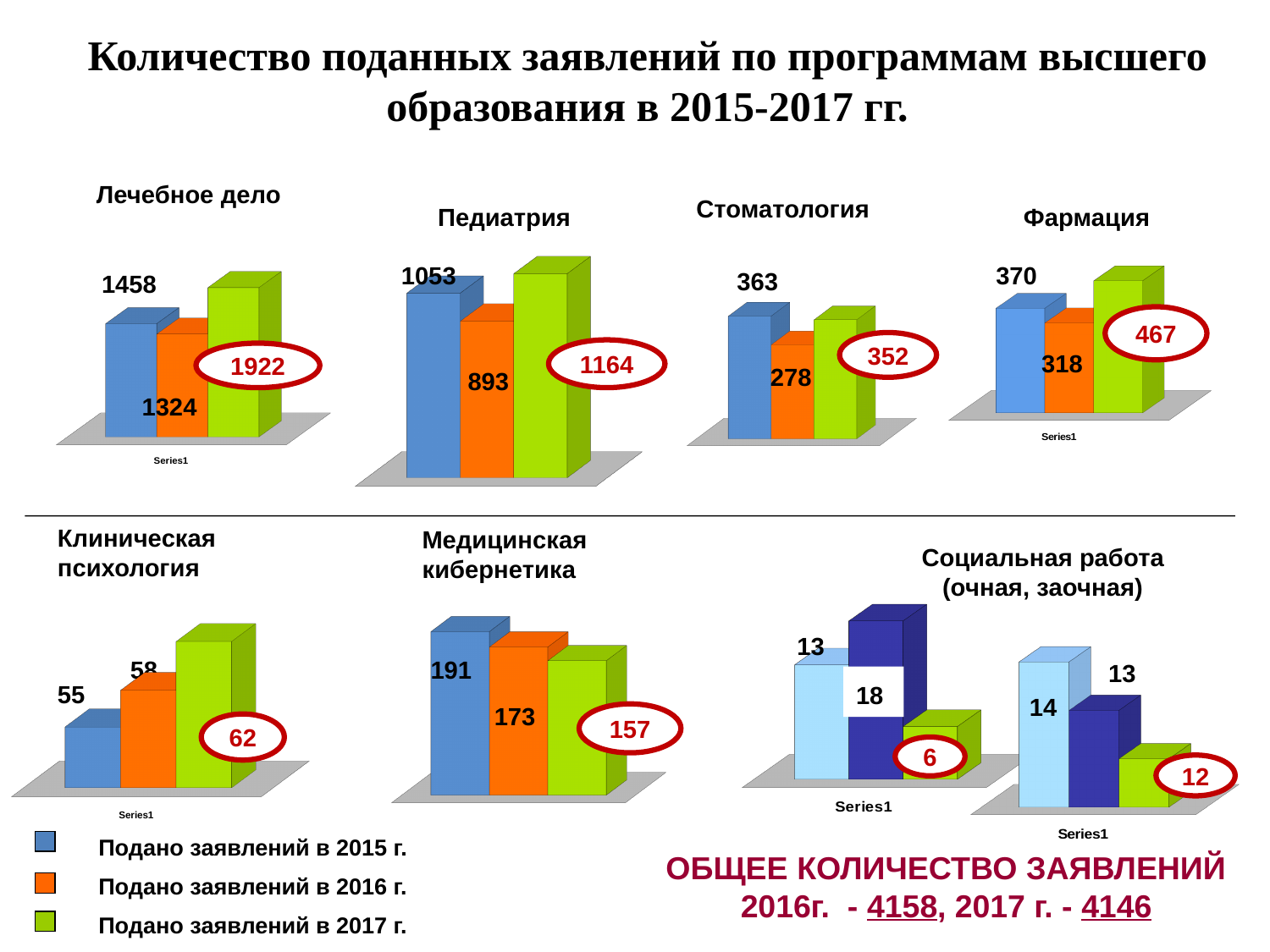
In the Стоматология chart, which year has the lowest number of applications? 2016 In the Клиническая психология chart, which year has the highest value? 2017 In the Медицинская кибернетика chart, do the values rise or fall from 2015 to 2017? fall How many bars are shown in the Педиатрия chart? 3 How many entries does the legend at the bottom left of the slide list? 3 In the Фармация chart, what is the difference between the 2017 and 2015 values? 97 In the Социальная работа chart, what is the value of the first group's 2016 bar? 18 In the Лечебное дело chart, what is the number of applications submitted in 2017? 1922 In the Стоматология chart, what is the difference between the 2015 and 2017 values? 11 In the Лечебное дело chart, which is larger: the 2015 value or the 2016 value? 2015 (1458) In the Педиатрия chart, what is the value for applications submitted in 2016? 893 What kind of chart is used for Фармация? bar chart